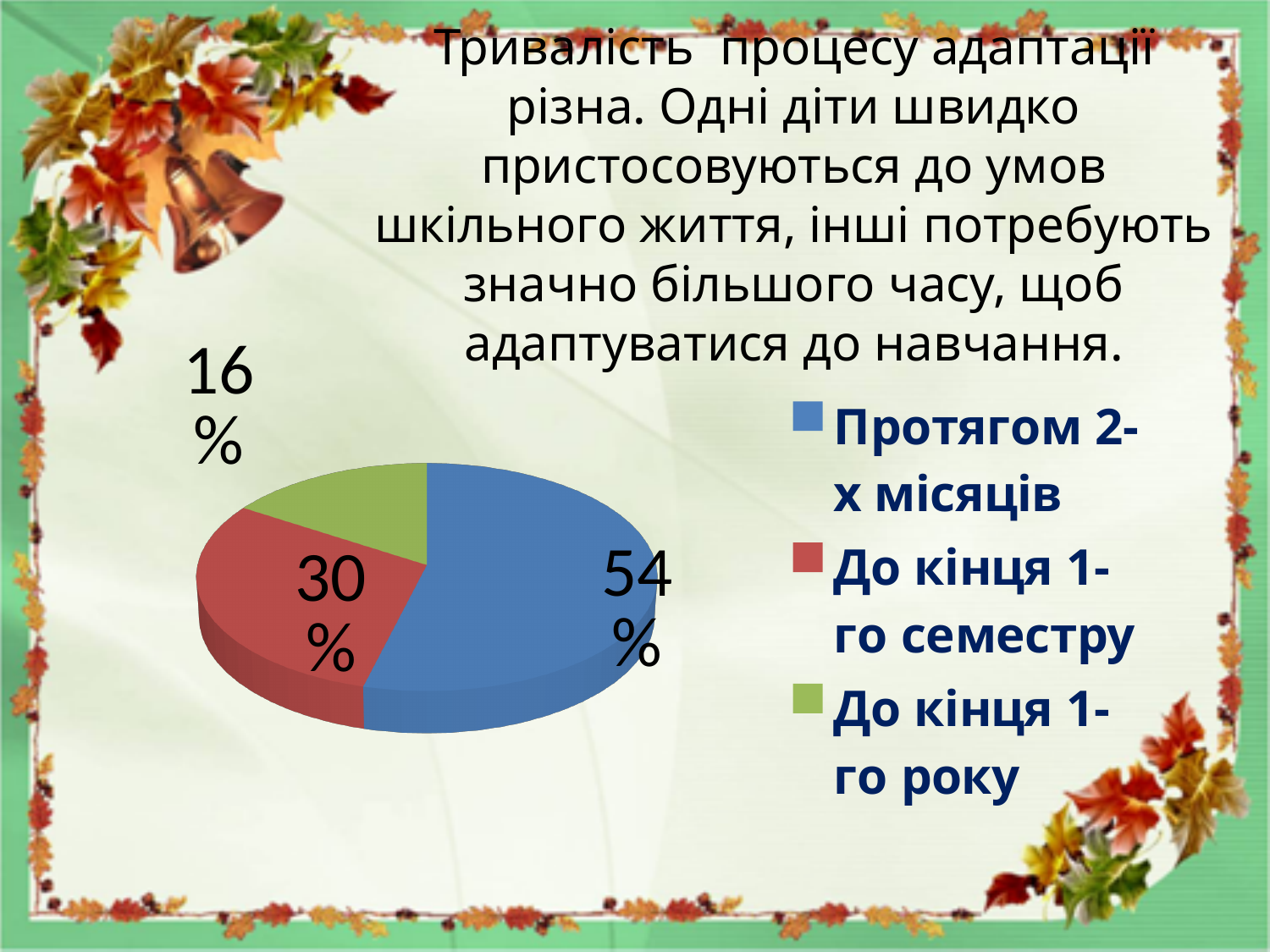
How many entries does the legend list? 3 Which category has the largest share of the pie? Протягом 2-х місяців Which is larger: the share for "До кінця 1-го семестру" or for "До кінця 1-го року"? До кінця 1-го семестру What is the difference between the shares for "Протягом 2-х місяців" and "До кінця 1-го семестру"? 24% What colour is the slice for "До кінця 1-го року"? green What colour is the slice for "Протягом 2-х місяців"? blue What percentage is shown for "До кінця 1-го семестру"? 30% Which category has the smallest share of the pie? До кінця 1-го року What percentage of children adapt "Протягом 2-х місяців"? 54% How many slices does the pie chart have? 3 What kind of chart is shown on the slide? pie chart What percentage is shown for "До кінця 1-го року"? 16%